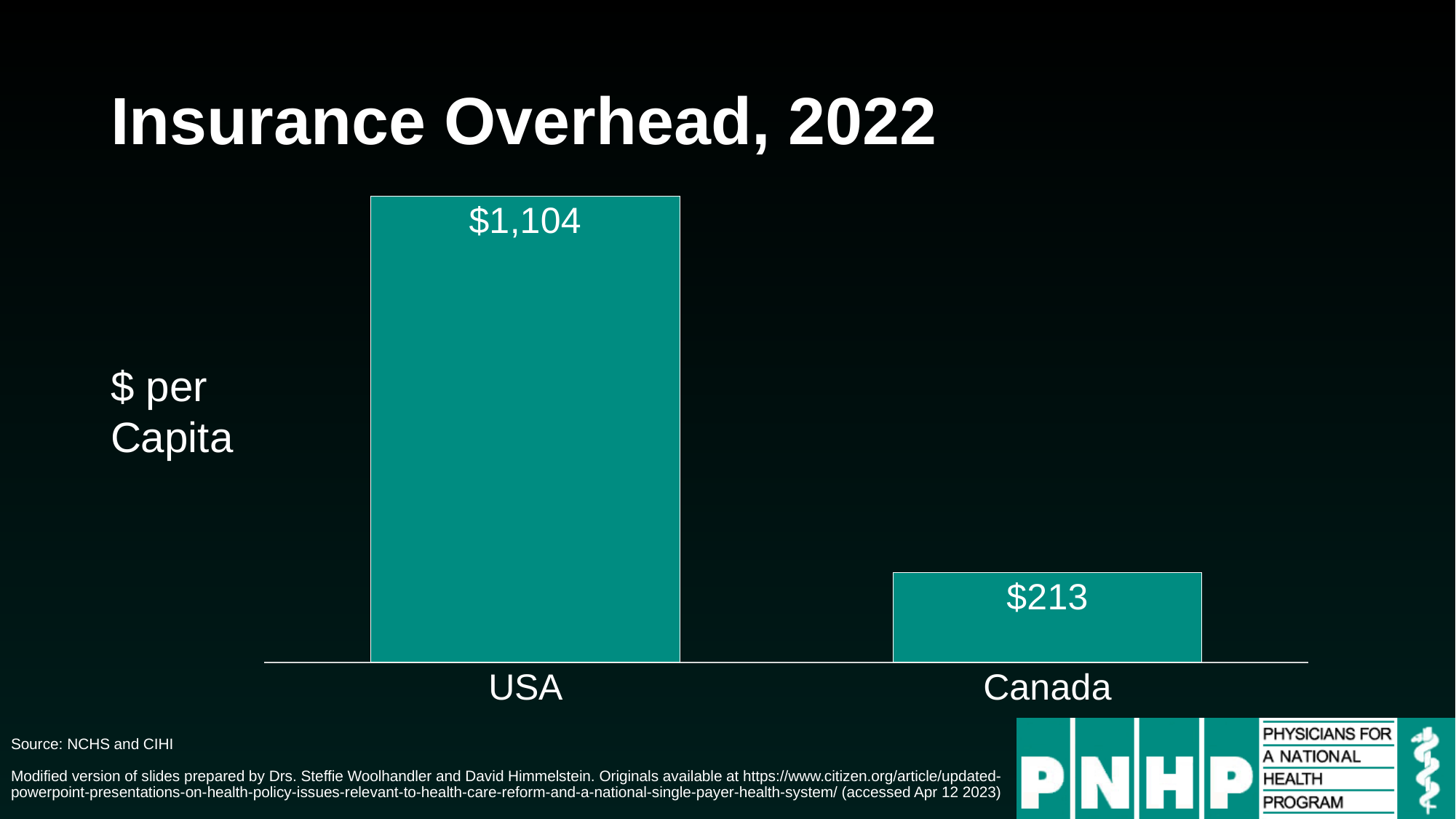
What unit is the chart's vertical axis labelled with? $ per Capita Which country has the higher insurance overhead per capita? USA What kind of chart is shown on the slide? Bar chart What is the insurance overhead per capita for Canada? $213 Which country has the lower insurance overhead per capita? Canada Is the insurance overhead per capita larger for the USA or for Canada? USA How many countries are shown in the chart? 2 What is the insurance overhead per capita for the USA? $1,104 What is the title of the chart? Insurance Overhead, 2022 What is the difference in insurance overhead per capita between the USA and Canada? $891